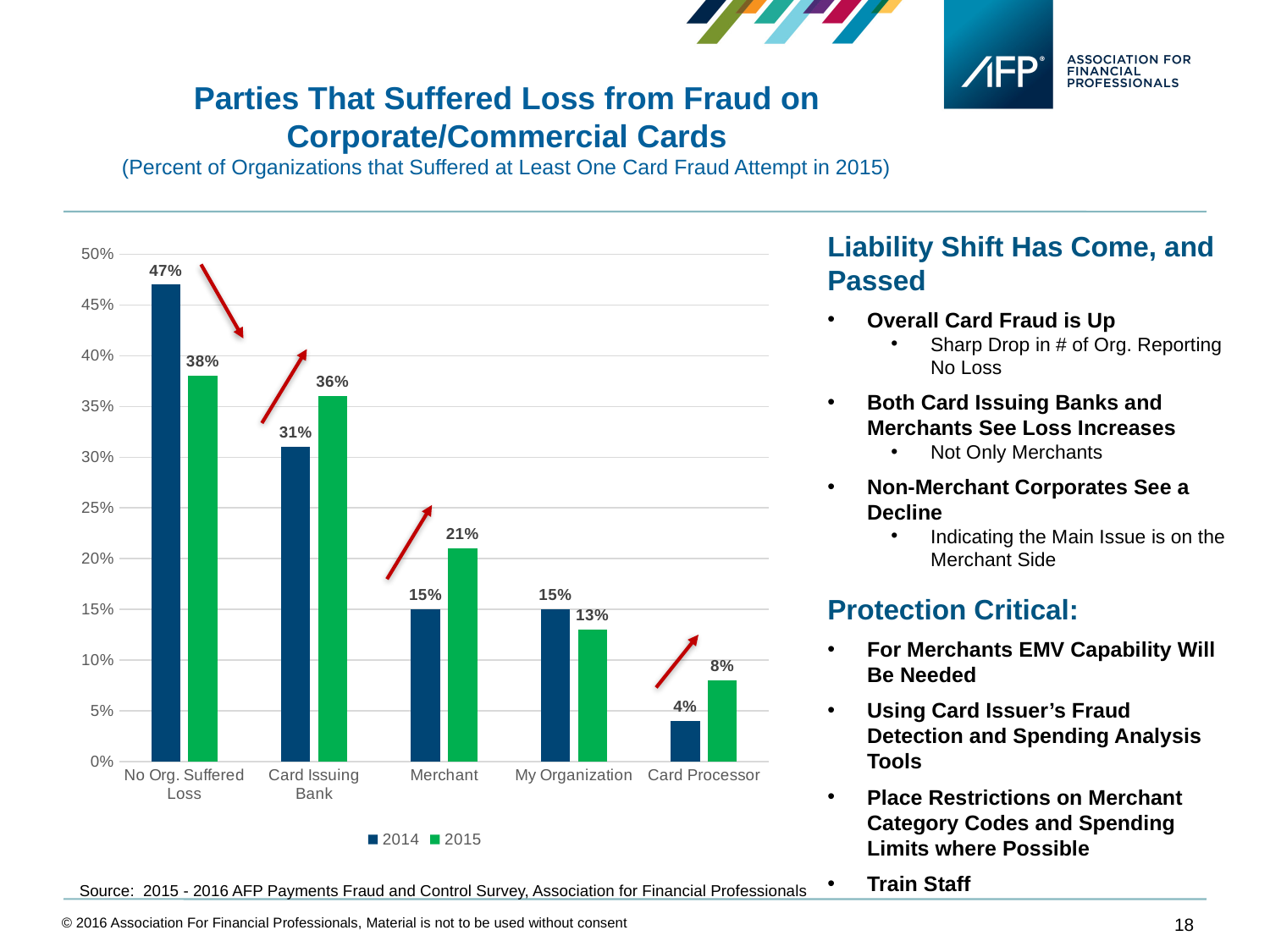
What is the difference between the 2014 and 2015 values for No Org. Suffered Loss? 9% What was the 2014 value for Card Processor? 4% What was the 2015 value for Merchant? 21% How many categories are shown on the x axis? 5 Which category has the lowest 2014 value? Card Processor How many series does the legend list? 2 Which is larger for My Organization, the 2014 value or the 2015 value? 2014 What is the difference between the 2015 and 2014 values for Merchant? 6% What was the 2015 value for Card Issuing Bank? 36% What was the 2014 value for No Org. Suffered Loss? 47% What kind of chart is shown on the slide? Bar chart Which category has the highest 2015 value? No Org. Suffered Loss